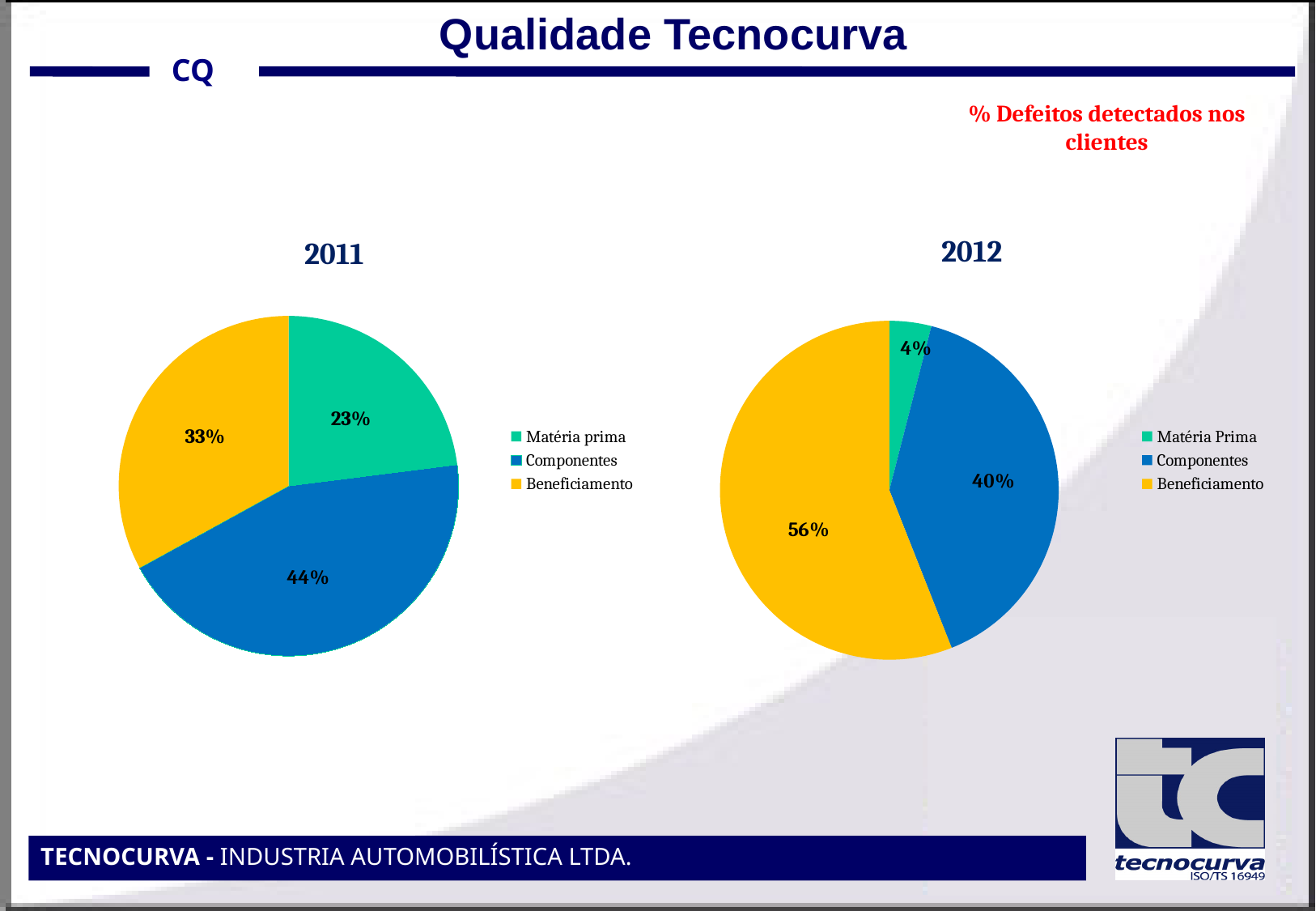
In the 2012 pie chart, what share is labelled for Beneficiamento? 56% In the 2011 pie chart, what share is labelled for Matéria prima? 23% What type of chart is used for the 2011 and 2012 data? Pie chart In the 2011 pie chart, what is the difference in percentage points between Componentes and Beneficiamento? 11 Which is larger: the Matéria prima share in the 2011 chart or the Matéria Prima share in the 2012 chart? 2011 In the 2012 pie chart, what share is labelled for Matéria Prima? 4% How many categories does the legend of the 2012 pie chart list? 3 In the 2012 pie chart, what is the difference in percentage points between Beneficiamento and Componentes? 16 In the 2011 pie chart, what share is labelled for Componentes? 44% In the 2012 pie chart, which category has the largest slice? Beneficiamento In the 2011 pie chart, which category has the largest slice? Componentes In the 2012 pie chart, which category has the smallest slice? Matéria Prima